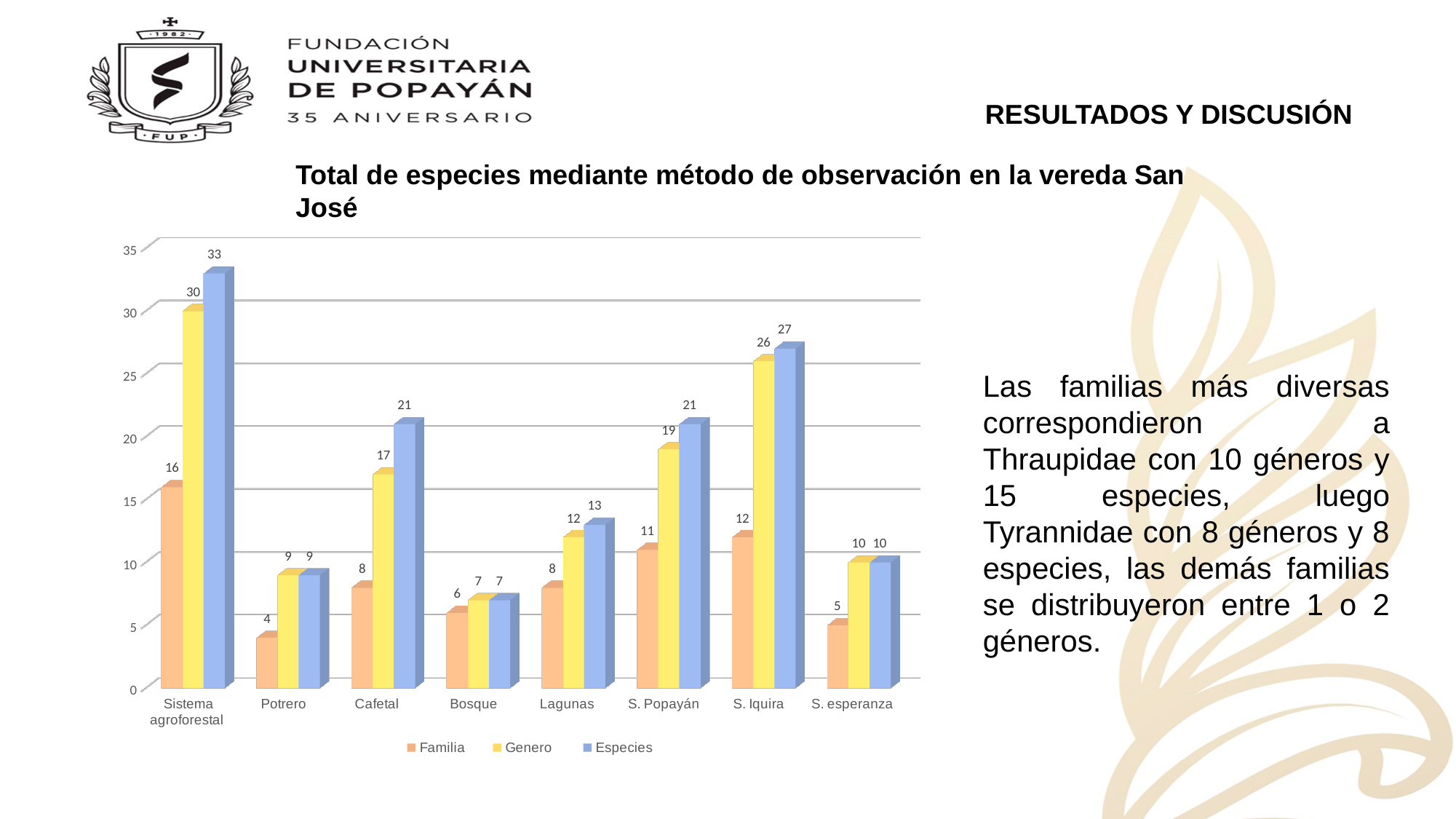
What kind of chart is shown on the slide? bar chart What is the Familia value for S. Iquira? 12 Which is larger, the Especies value for Cafetal or the Especies value for Lagunas? Cafetal What is the Especies value for Sistema agroforestal? 33 What is the difference between the Genero and Familia values for S. Popayán? 8 How many series does the legend list? 3 How many categories are shown on the x axis? 8 Which category has the lowest Familia value? Potrero What is the title of the chart? Total de especies mediante método de observación en la vereda San José What is the Genero value for Cafetal? 17 Which category has the highest Especies value? Sistema agroforestal What is the difference between the Especies values for S. Iquira and S. esperanza? 17